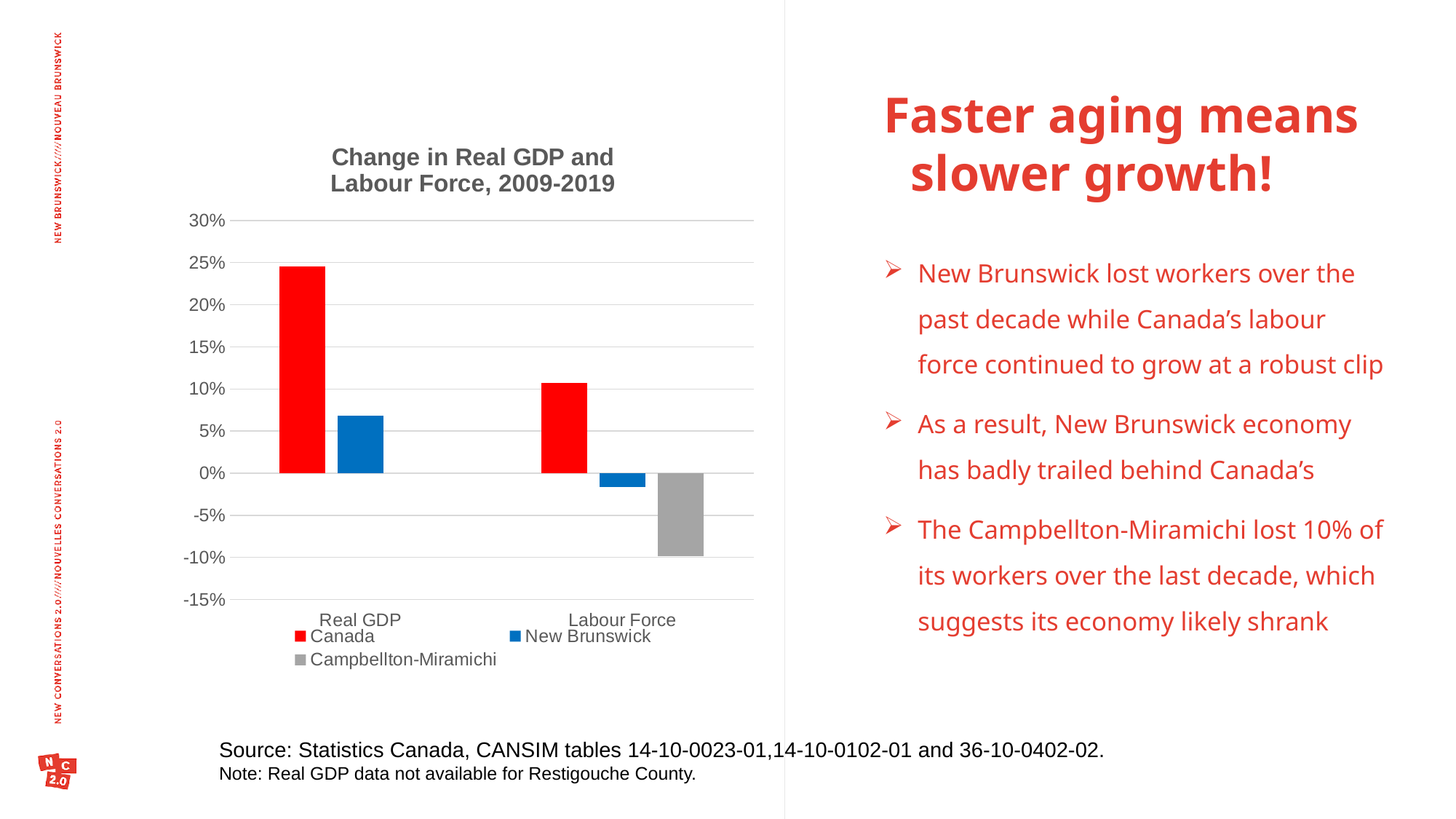
Which is larger: Canada's Real GDP change or Canada's Labour Force change? Real GDP Is the value for New Brunswick's Labour Force greater or less than 0%? less How many categories are shown on the x axis? 2 Is the value for Canada's Labour Force greater or less than 5%? greater Which series has the highest value for Real GDP? Canada What kind of chart is shown on the slide? bar chart Which series has the lowest value for Labour Force? Campbellton-Miramichi Is the value for Canada's Real GDP greater or less than 20%? greater Which is larger: New Brunswick's Labour Force change or Campbellton-Miramichi's Labour Force change? New Brunswick How many series does the legend list? 3 What is the title of the chart? Change in Real GDP and Labour Force, 2009-2019